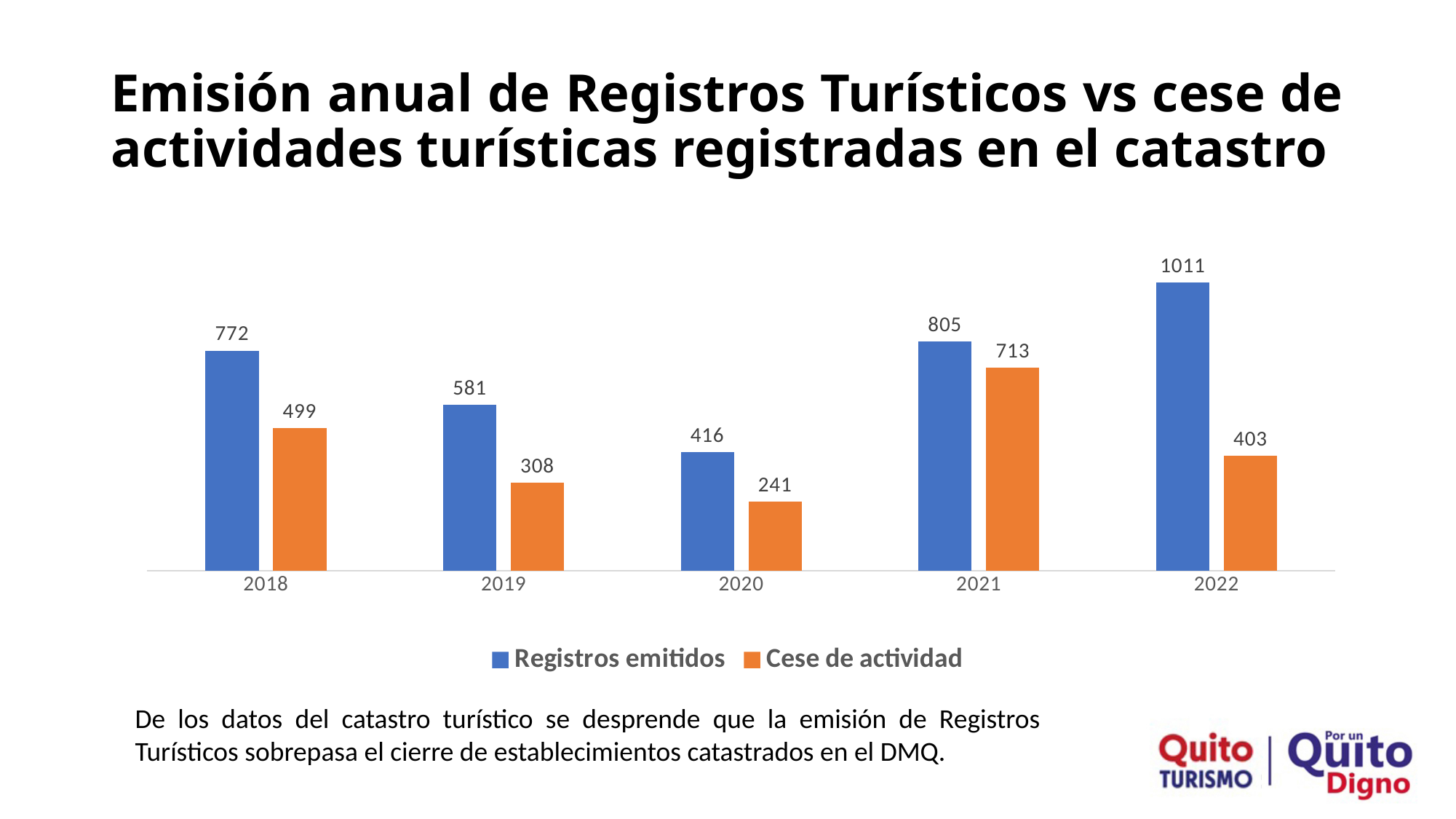
What is the value of Registros emitidos for 2022? 1011 What is the difference between Registros emitidos in 2022 and in 2018? 239 Which year has the lowest value for Cese de actividad? 2020 What kind of chart is shown on the slide? Bar chart What is the value of Cese de actividad for 2019? 308 What is the difference between Registros emitidos and Cese de actividad in 2021? 92 How many series does the legend list? 2 What is the value of Registros emitidos for 2020? 416 Which is larger: Cese de actividad in 2018 or Cese de actividad in 2022? Cese de actividad in 2018 Which colour represents Cese de actividad in the chart? Orange How many years are shown on the x axis? 5 Which year has the highest value for Registros emitidos? 2022